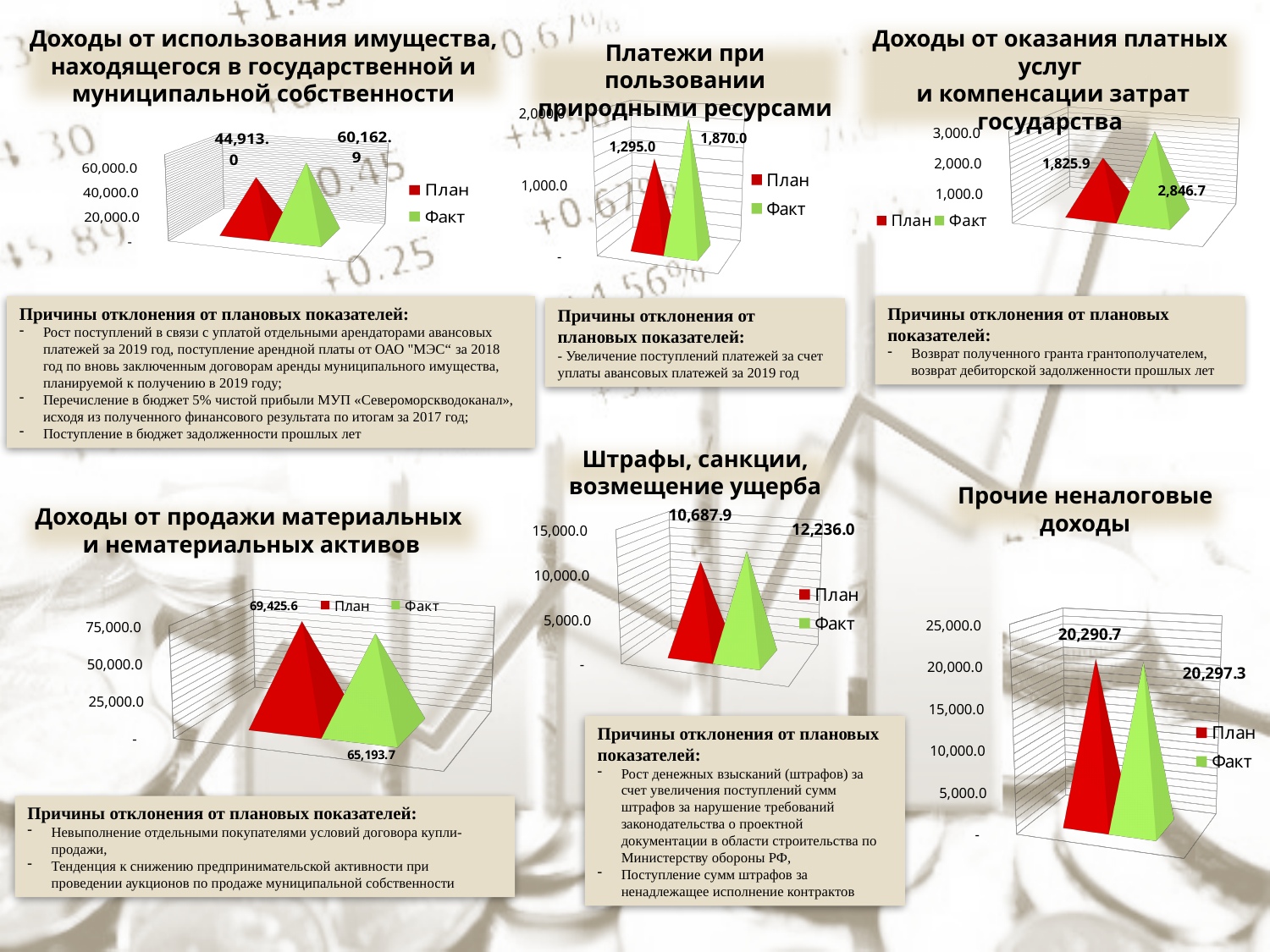
In the chart 'Доходы от оказания платных услуг и компенсации затрат государства', what is the value for Факт? 2,846.7 In the chart 'Штрафы, санкции, возмещение ущерба', what is the value for Факт? 12,236.0 In the chart 'Доходы от использования имущества, находящегося в государственной и муниципальной собственности', which is larger, План or Факт? Факт In the chart 'Платежи при пользовании природными ресурсами', what is the value for План? 1,295.0 In the chart 'Доходы от продажи материальных и нематериальных активов', which is larger, План or Факт? План In the chart 'Платежи при пользовании природными ресурсами', what is the value for Факт? 1,870.0 In the chart 'Прочие неналоговые доходы', what is the value for План? 20,290.7 In the chart 'Штрафы, санкции, возмещение ущерба', what is the difference between Факт and План? 1,548.1 In the chart 'Доходы от продажи материальных и нематериальных активов', what is the value for План? 69,425.6 How many series does the legend list in the chart 'Прочие неналоговые доходы'? 2 In the chart 'Доходы от оказания платных услуг и компенсации затрат государства', what is the difference between Факт and План? 1,020.8 What colour represents Факт in the chart 'Штрафы, санкции, возмещение ущерба'? Green